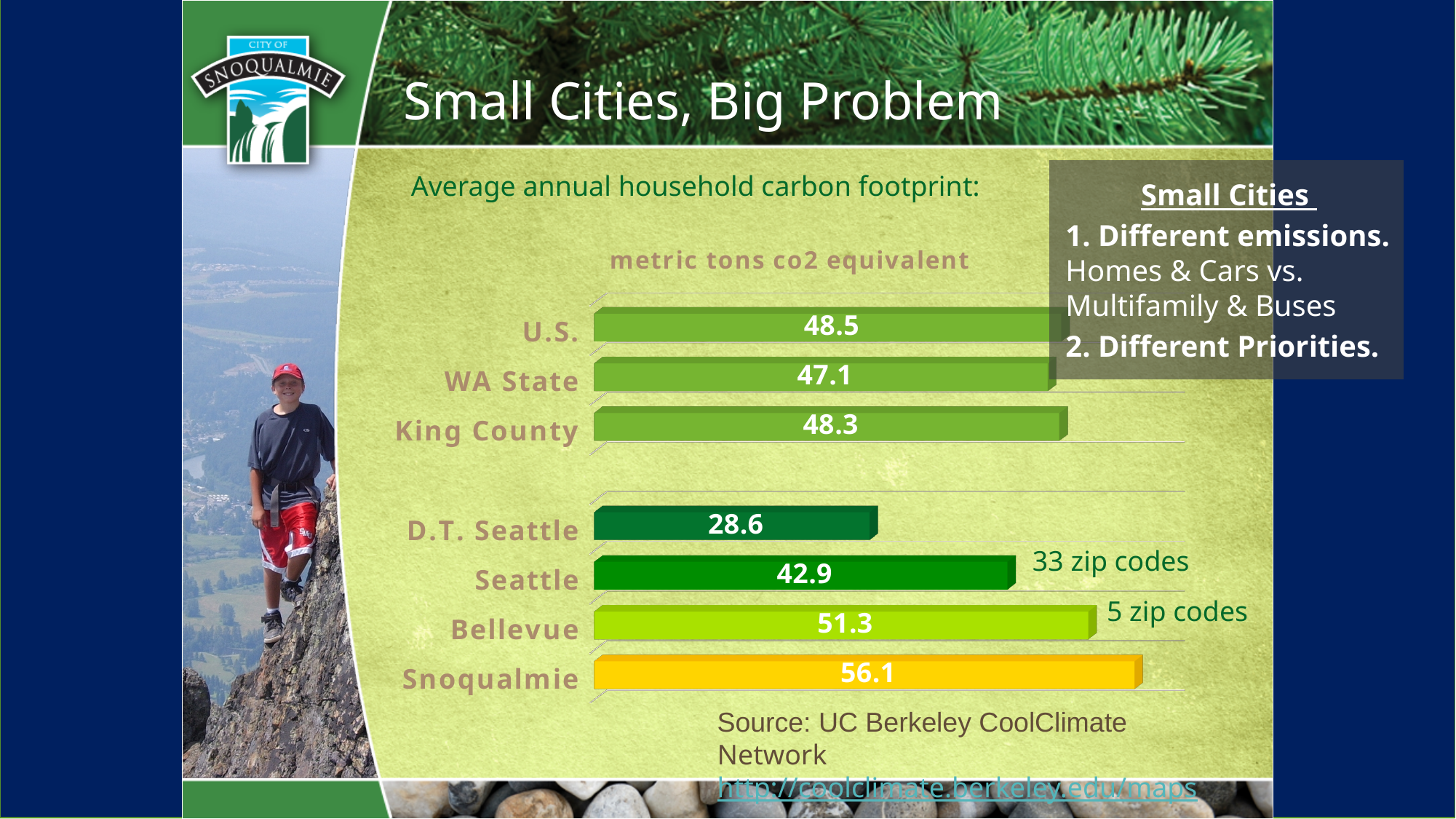
What is the value for WA State? 47.1 What kind of chart is shown on the slide? Bar chart What value is shown for D.T. Seattle? 28.6 What is the average annual household carbon footprint for Snoqualmie? 56.1 How many categories are plotted in the chart? 7 Which has a larger value, U.S. or WA State? U.S. What is the difference between the values for Snoqualmie and Bellevue? 4.8 Which has a larger value, Bellevue or Seattle? Bellevue Which category has the highest value in the chart? Snoqualmie What is the difference between the values for Seattle and D.T. Seattle? 14.3 What is the title shown above the bars in the chart? metric tons co2 equivalent Which category has the lowest value in the chart? D.T. Seattle